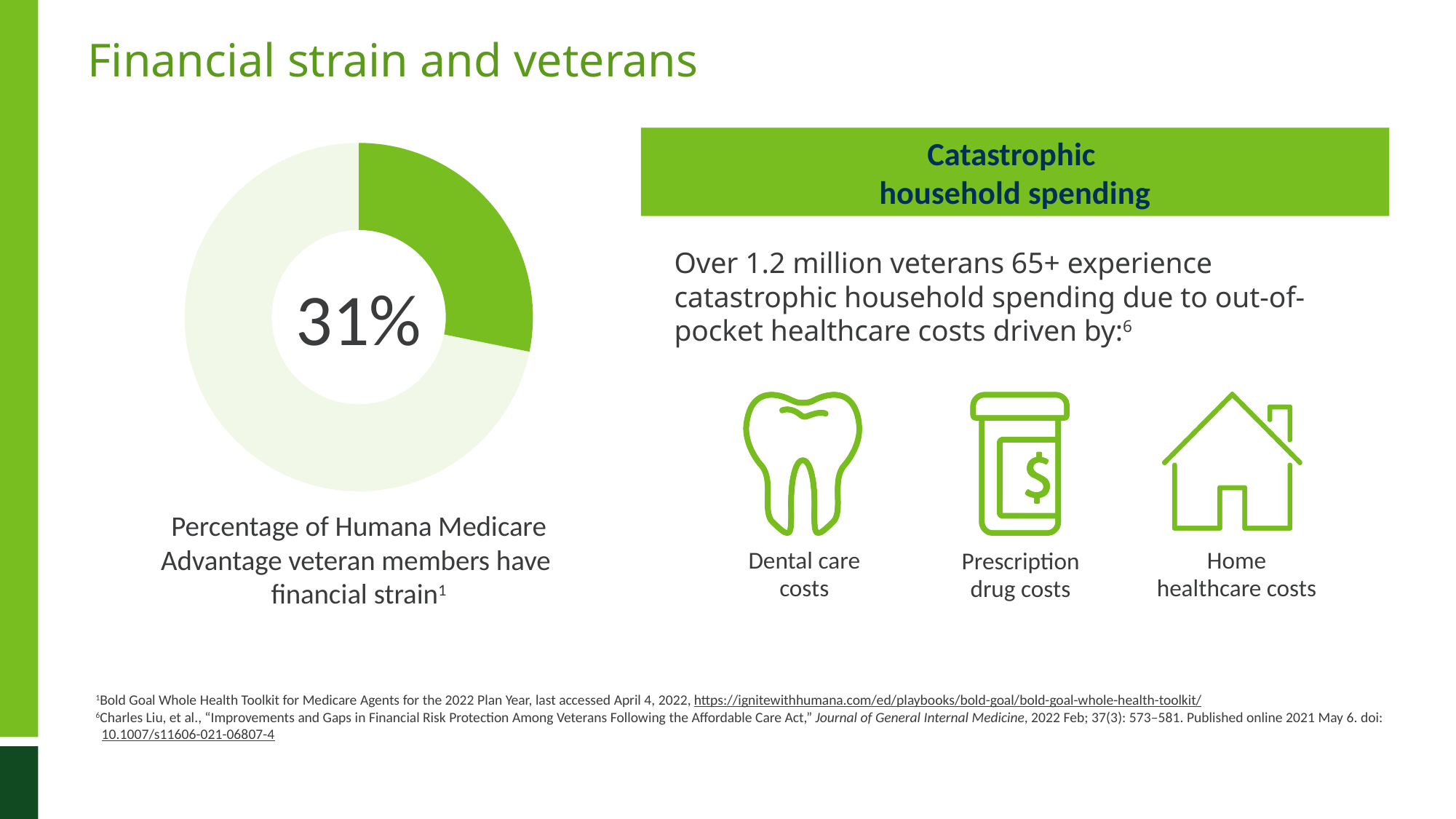
What colour is the slice representing the 31% in the donut chart? Green What percentage is shown in the centre of the donut chart? 31% According to the chart caption, what does the 31% represent? Percentage of Humana Medicare Advantage veteran members have financial strain What share of the donut chart does the green slice represent? 31% How many slices does the donut chart have? 2 Which slice of the donut chart is larger, the green slice or the light grey slice? The light grey slice What kind of chart is shown on the left of the slide? Donut (pie) chart